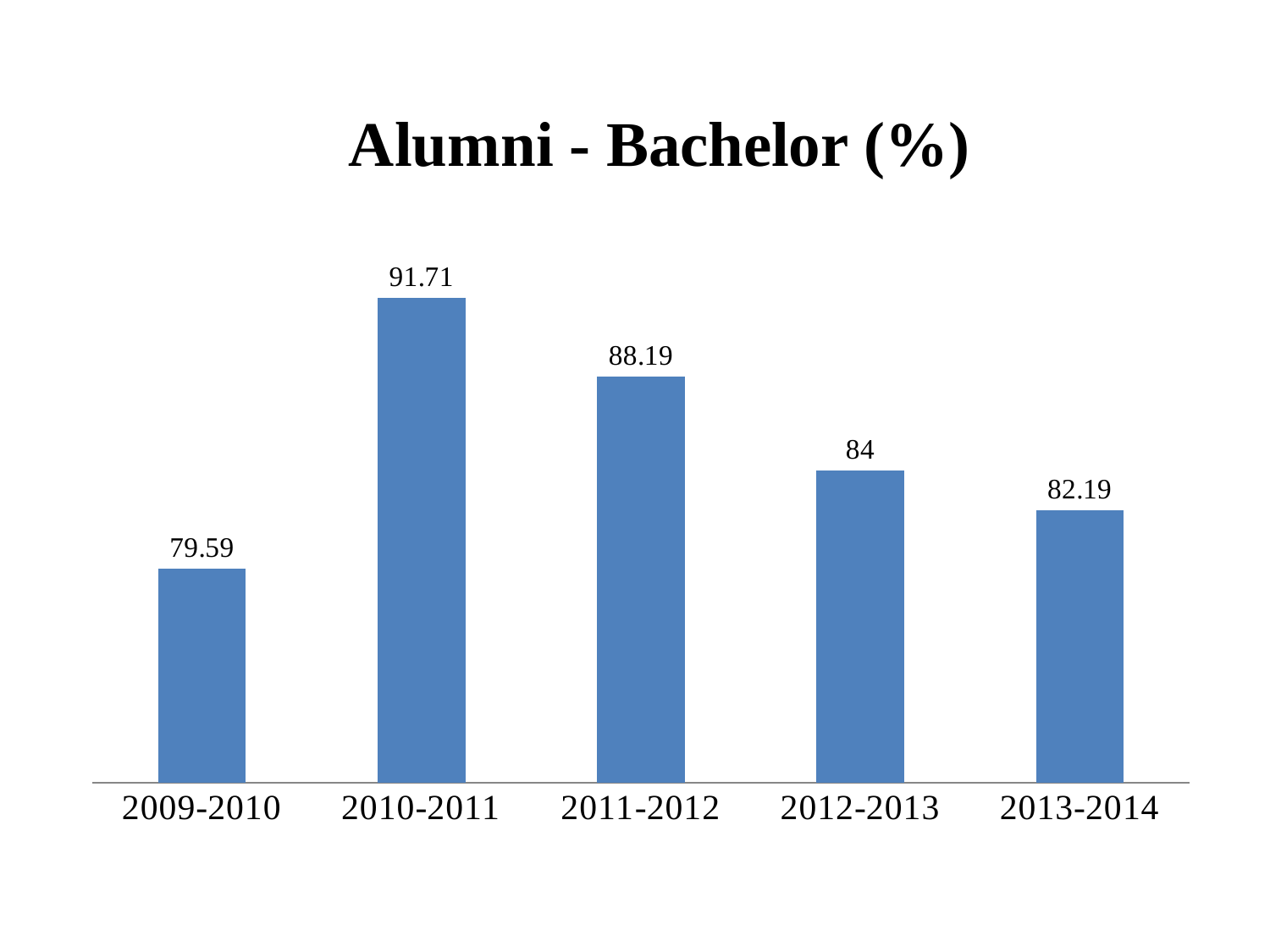
What is the value for 2012-2013? 84 Which is larger, the value for 2011-2012 or the value for 2013-2014? 2011-2012 Which year has the lowest value? 2009-2010 How many years are shown on the chart? 5 Do the values rise or fall from 2010-2011 to 2013-2014? Fall What is the value for 2013-2014? 82.19 What is the difference between the values for 2011-2012 and 2012-2013? 4.19 What is the title of the chart? Alumni - Bachelor (%) What is the difference between the values for 2010-2011 and 2009-2010? 12.12 What kind of chart is this? Bar chart What is the value for 2010-2011? 91.71 Which year has the highest value? 2010-2011